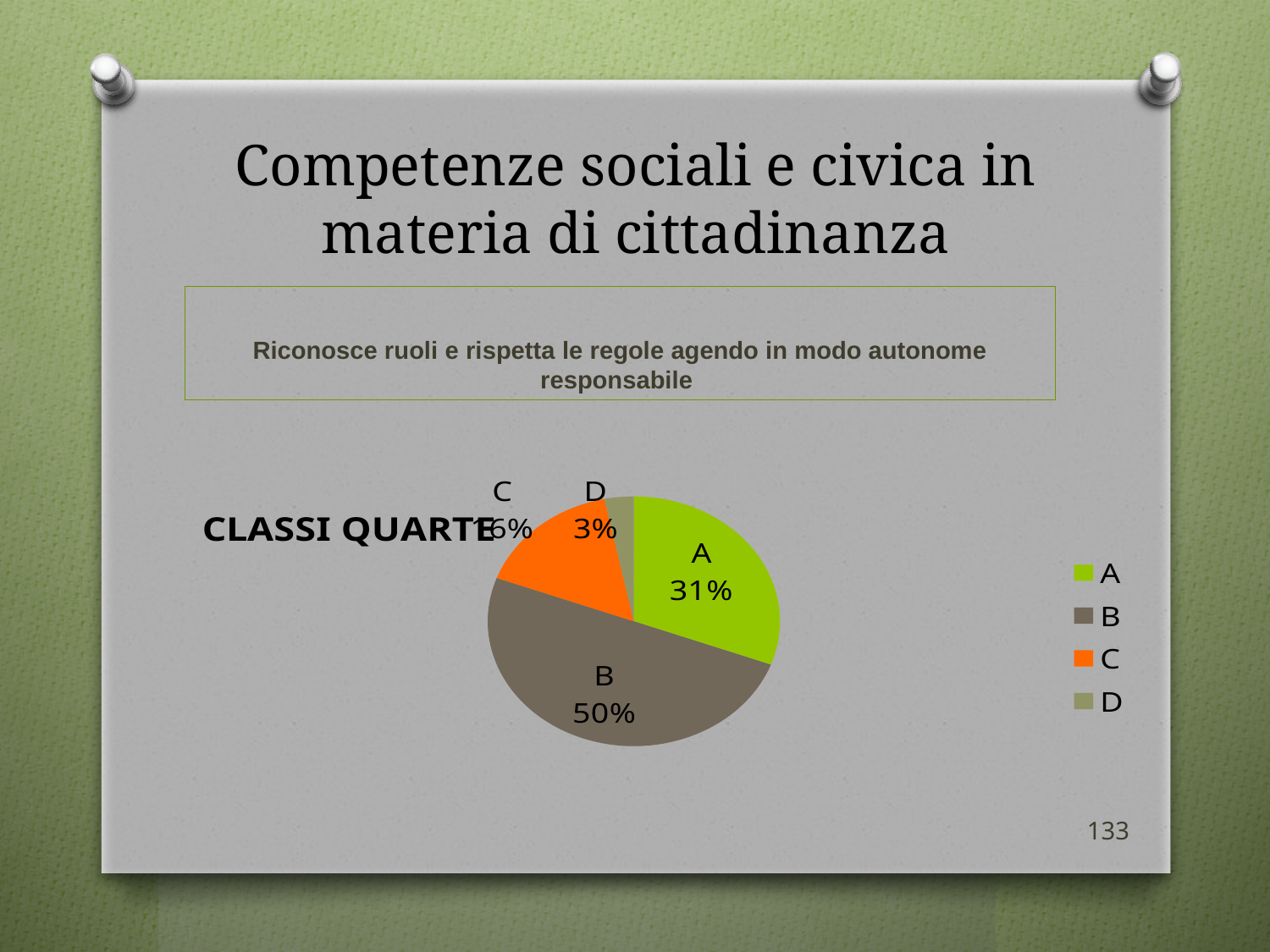
Which is larger, slice A or slice C? A How many entries does the legend list? 4 Which category has the largest slice in the pie chart? B What percentage does slice D represent in the pie chart? 3% How many slices does the pie chart have? 4 What type of chart is shown on the slide? Pie chart What percentage does slice B represent in the pie chart? 50% Which category has the smallest slice in the pie chart? D What is the difference in percentage points between slice A and slice D? 28 Which is larger, slice C or slice D? C What percentage does slice A represent in the pie chart? 31% What is the difference in percentage points between slice B and slice A? 19